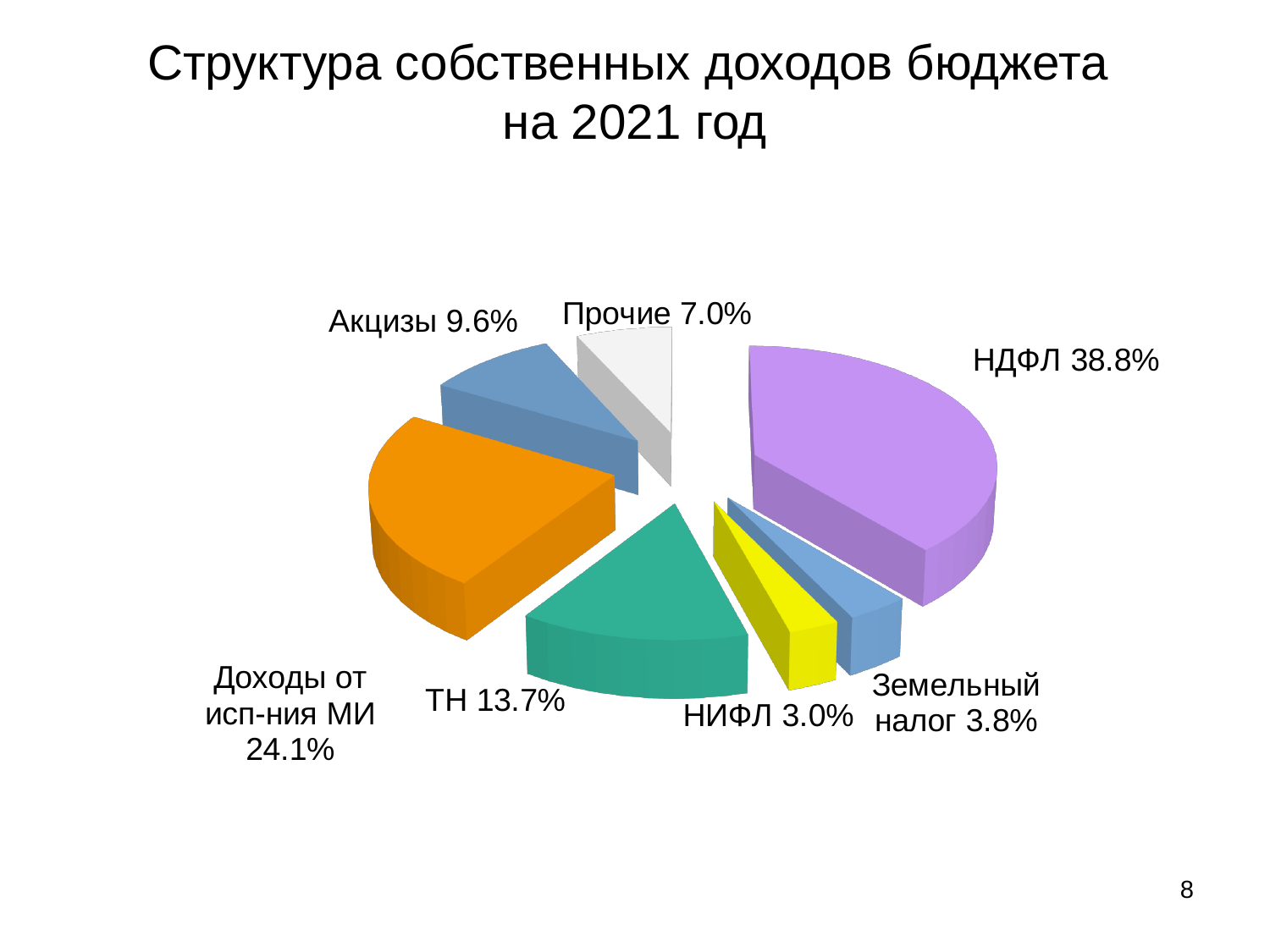
What share of the pie does НДФЛ have? 38.8% What is the title of the chart? Структура собственных доходов бюджета на 2021 год What kind of chart is shown on the slide? Pie chart How many slices does the pie chart have? 7 Which is larger, ТН or Акцизы? ТН Which category has the smallest slice? НИФЛ What is the value shown for Земельный налог? 3.8% Which category has the largest slice? НДФЛ What is the difference between the shares of НДФЛ and Доходы от исп-ния МИ? 14.7% What is the value shown for Акцизы? 9.6% What is the value shown for Доходы от исп-ния МИ? 24.1% What is the difference between the shares of Прочие and НИФЛ? 4.0%